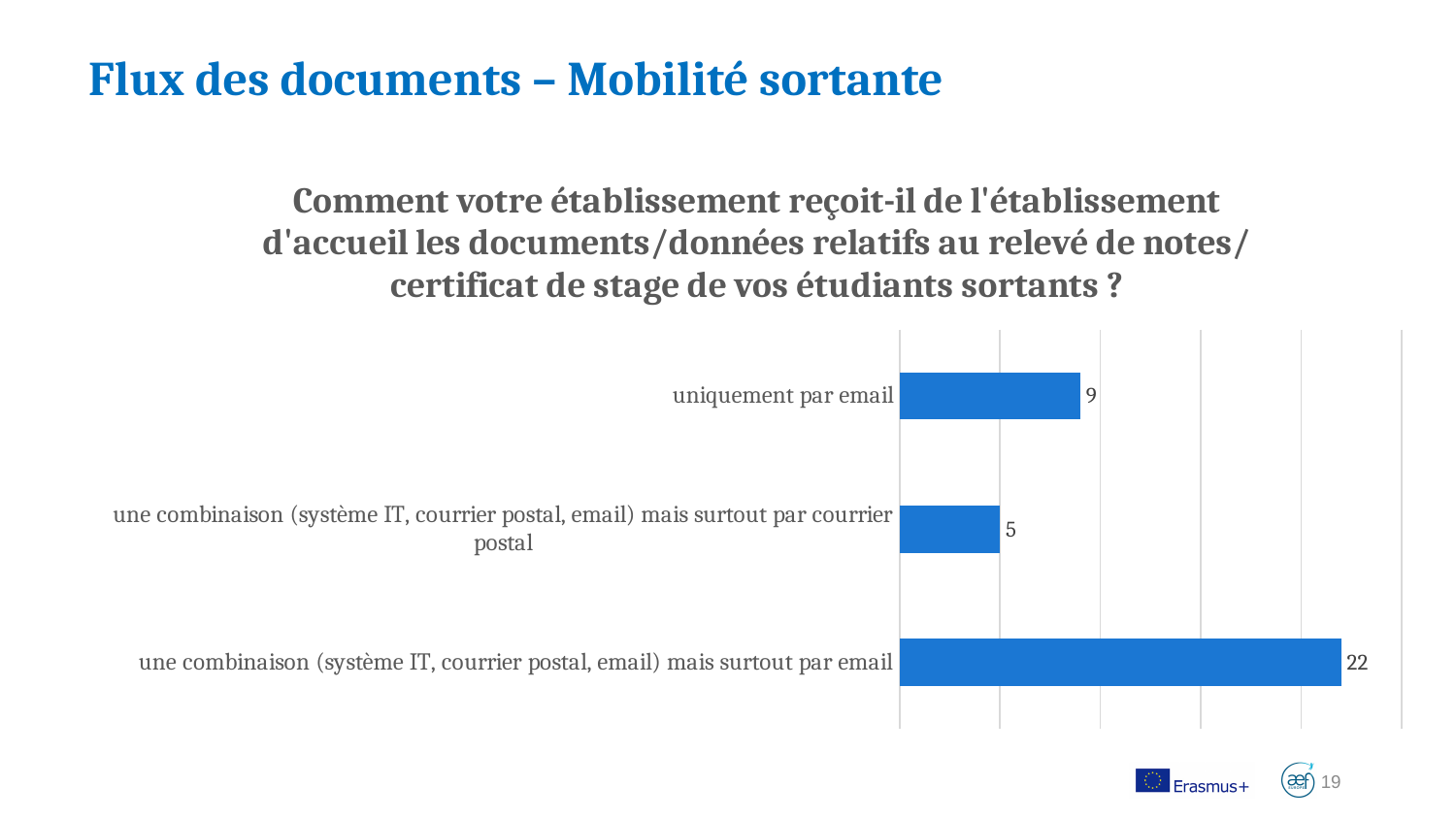
What is the difference between the value for "une combinaison ... mais surtout par email" and the value for "uniquement par email"? 13 Which is larger: the value for "uniquement par email" or the value for "une combinaison ... mais surtout par courrier postal"? uniquement par email Which category has the highest value? une combinaison (système IT, courrier postal, email) mais surtout par email What is the value for "une combinaison (système IT, courrier postal, email) mais surtout par email"? 22 What is the value for "uniquement par email"? 9 What is the total of all three values shown in the chart? 36 What kind of chart is shown on the slide? Bar chart What is the title of the slide? Flux des documents – Mobilité sortante What is the value for "une combinaison (système IT, courrier postal, email) mais surtout par courrier postal"? 5 How many categories are shown in the chart? 3 What is the difference between the value for "uniquement par email" and the value for "une combinaison ... mais surtout par courrier postal"? 4 Which category has the lowest value? une combinaison (système IT, courrier postal, email) mais surtout par courrier postal